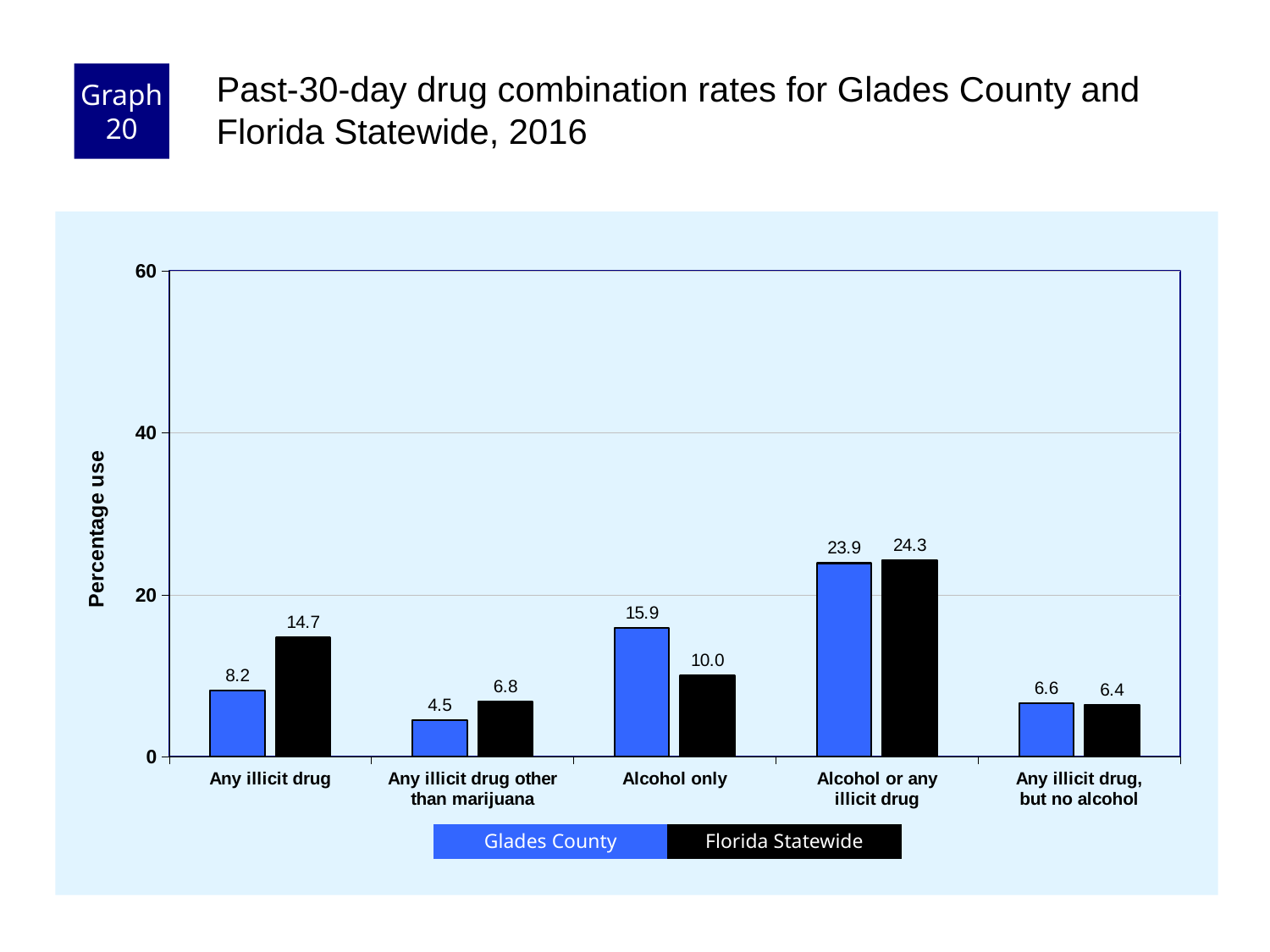
What kind of chart is shown? bar chart Which category has the lowest Glades County value? Any illicit drug other than marijuana What is the label of the y axis? Percentage use What is the difference between the Florida Statewide and Glades County values for Any illicit drug? 6.5 For Alcohol only, which is larger: Glades County or Florida Statewide? Glades County What is the Glades County value for Alcohol only? 15.9 How many series does the legend list? 2 What is the difference between the Glades County and Florida Statewide values for Alcohol only? 5.9 How many categories are shown on the x axis? 5 What is the Glades County value for Any illicit drug other than marijuana? 4.5 What is the Florida Statewide value for Any illicit drug? 14.7 Which category has the highest Florida Statewide value? Alcohol or any illicit drug